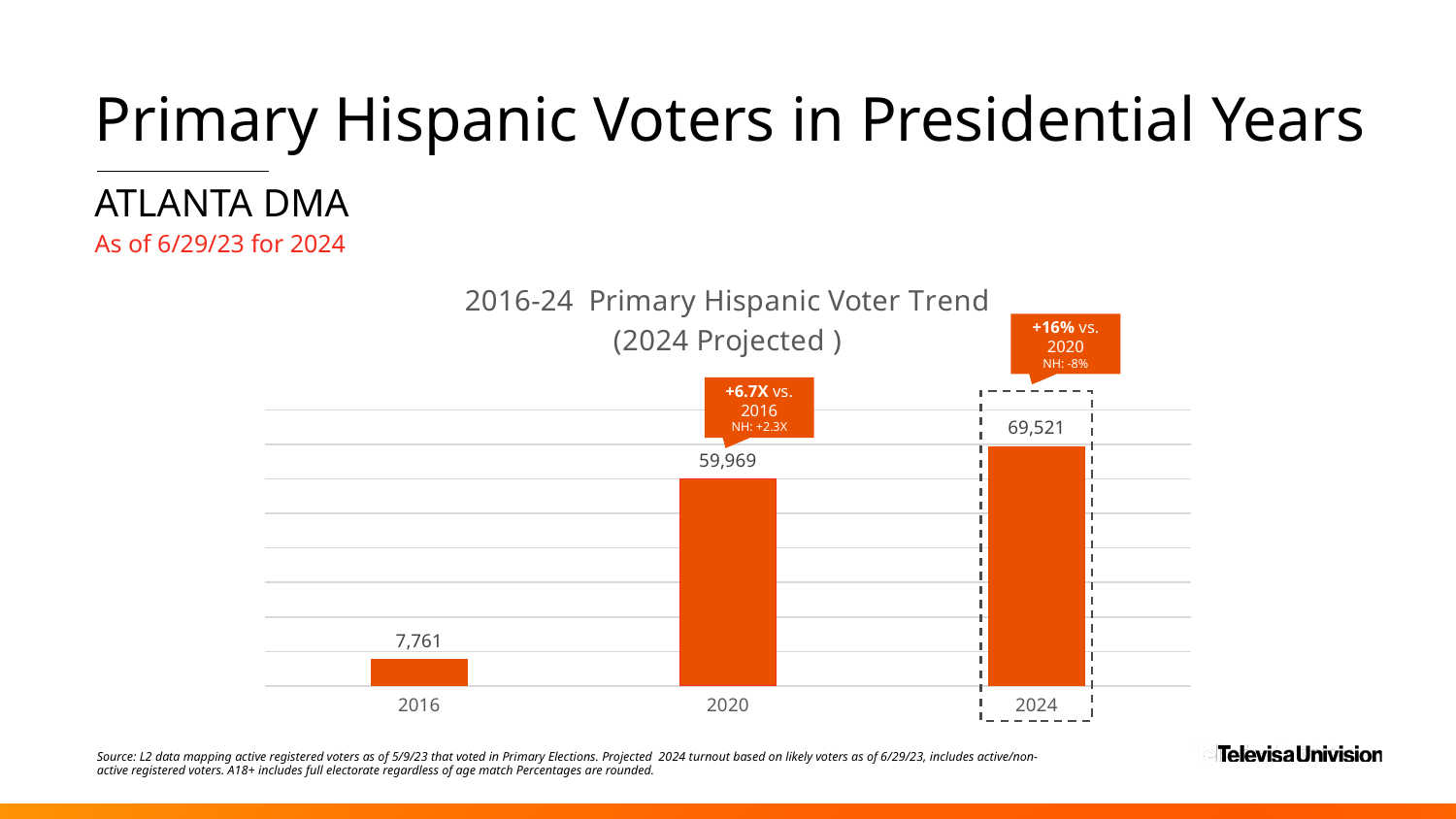
Which is larger, the value for 2020 or the value for 2016? 2020 What is the projected value for 2024 in the chart? 69,521 What kind of chart is shown on the slide? Bar chart What is the difference between the 2024 and 2020 values? 9,552 Which year has the lowest value in the chart? 2016 What is the value for 2020 in the chart? 59,969 What is the value for 2016 in the 2016-24 Primary Hispanic Voter Trend chart? 7,761 What is the difference between the 2020 and 2016 values? 52,208 How many years are plotted in the chart? 3 Which year has the highest value in the chart? 2024 Do the values rise or fall from 2016 to 2024? Rise According to the callout, what is the percentage change for 2024 vs. 2020? +16%